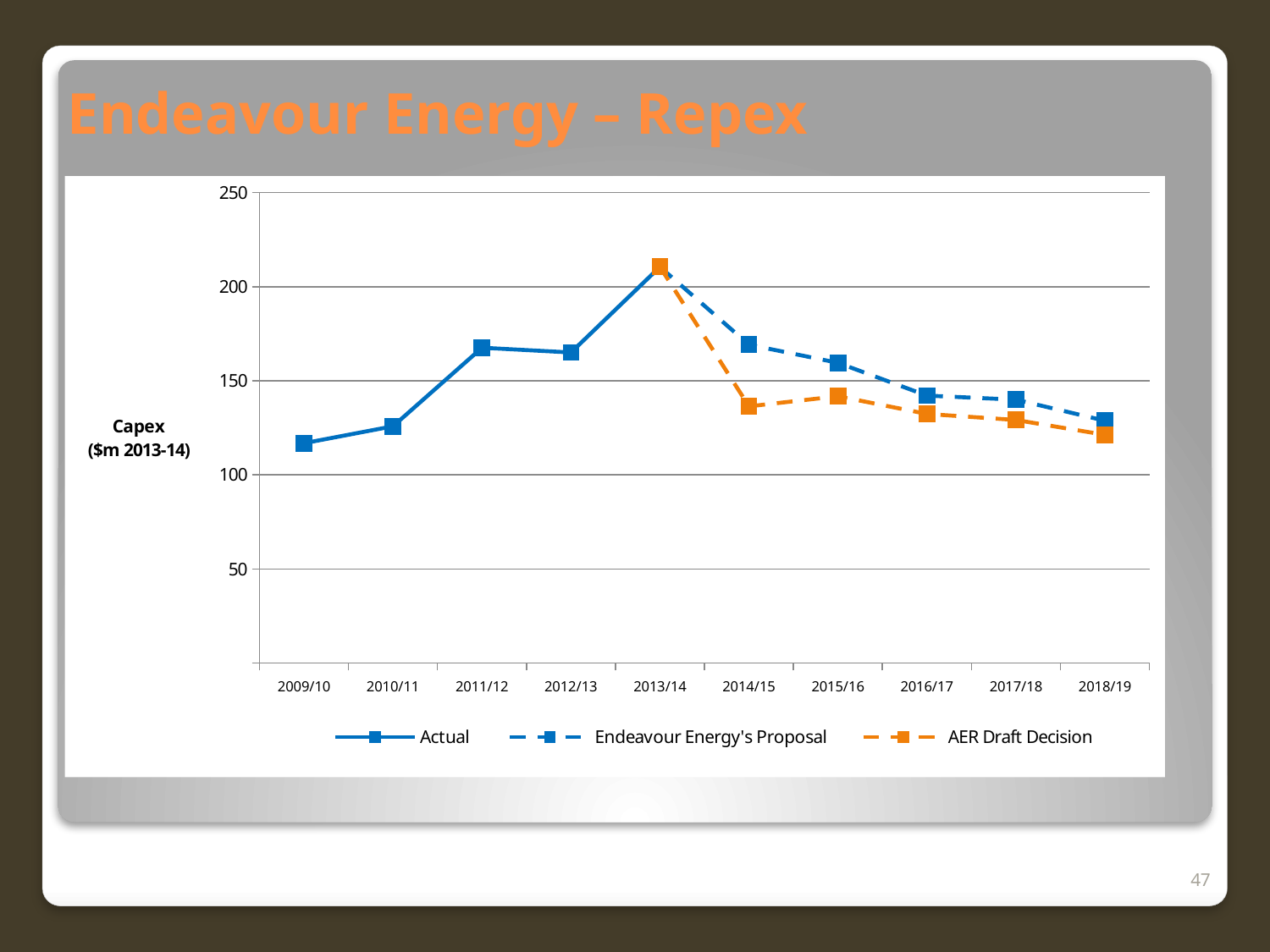
In 2014/15, which is larger: Endeavour Energy's Proposal or the AER Draft Decision? Endeavour Energy's Proposal Is the Actual value for 2013/14 greater or less than 200? greater Is the AER Draft Decision value for 2014/15 greater or less than 150? less Does the Actual series rise or fall from 2009/10 to 2013/14? Rise In which year is the Actual series at its lowest value? 2009/10 In which year does the Actual series reach its highest value? 2013/14 How many years are shown along the x axis? 10 What is the label on the vertical axis of the chart? Capex ($m 2013-14) Is the Endeavour Energy's Proposal value for 2014/15 greater or less than 150? greater What kind of chart is shown on the slide? Line chart How many series does the legend list? 3